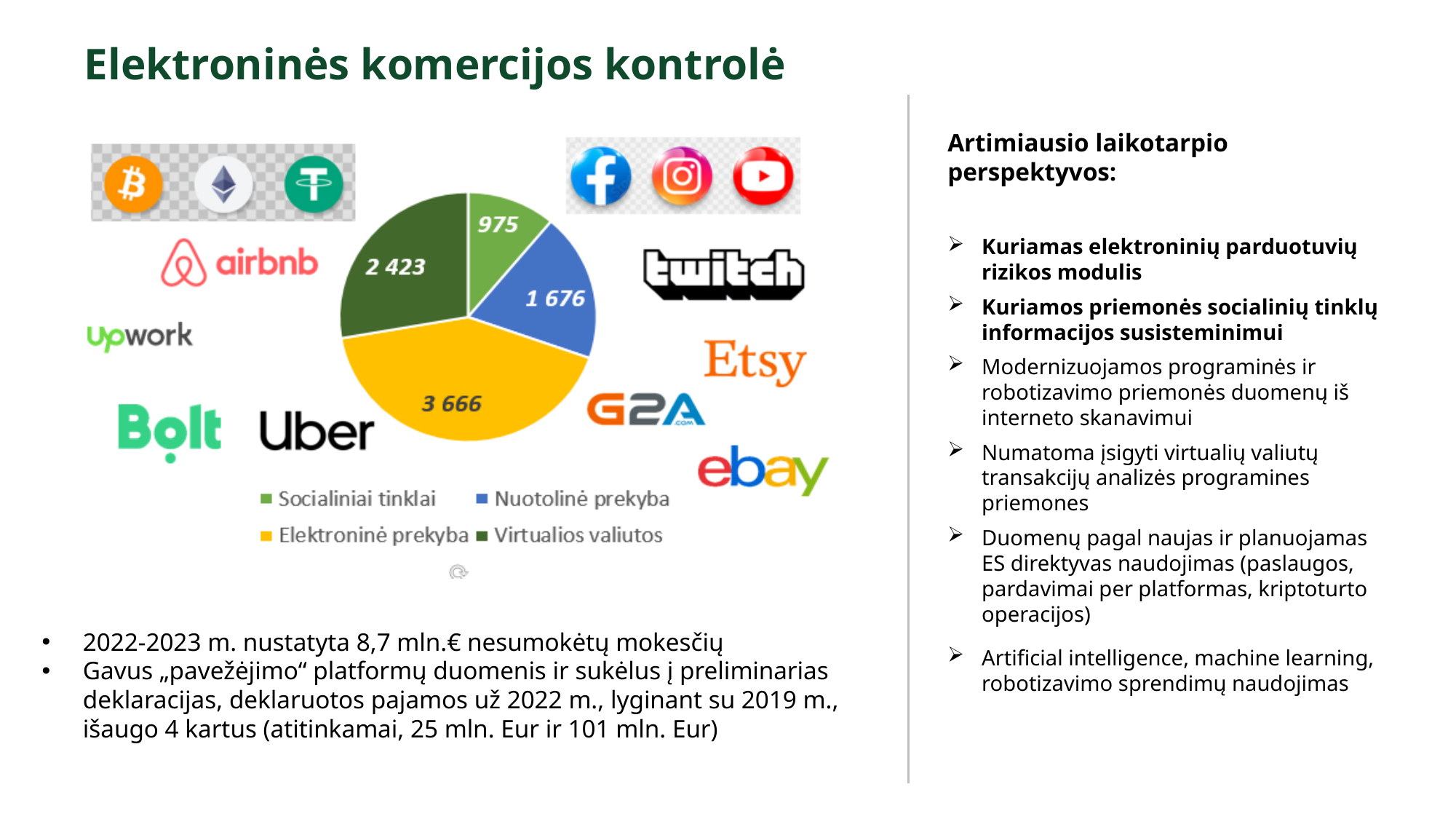
What is the total of all four slices in the pie chart? 8 740 What is the value for Nuotolinė prekyba in the pie chart? 1 676 What is the value for Virtualios valiutos in the pie chart? 2 423 What is the difference between the values for Elektroninė prekyba and Virtualios valiutos? 1 243 Which is larger, the value for Nuotolinė prekyba or the value for Virtualios valiutos? Virtualios valiutos Which colour represents Nuotolinė prekyba in the pie chart? Blue What is the value for Socialiniai tinklai in the pie chart? 975 What is the value for Elektroninė prekyba in the pie chart? 3 666 Which category has the smallest slice in the pie chart? Socialiniai tinklai How many categories does the pie chart have? 4 What kind of chart is shown on the slide? Pie chart Which category has the largest slice in the pie chart? Elektroninė prekyba